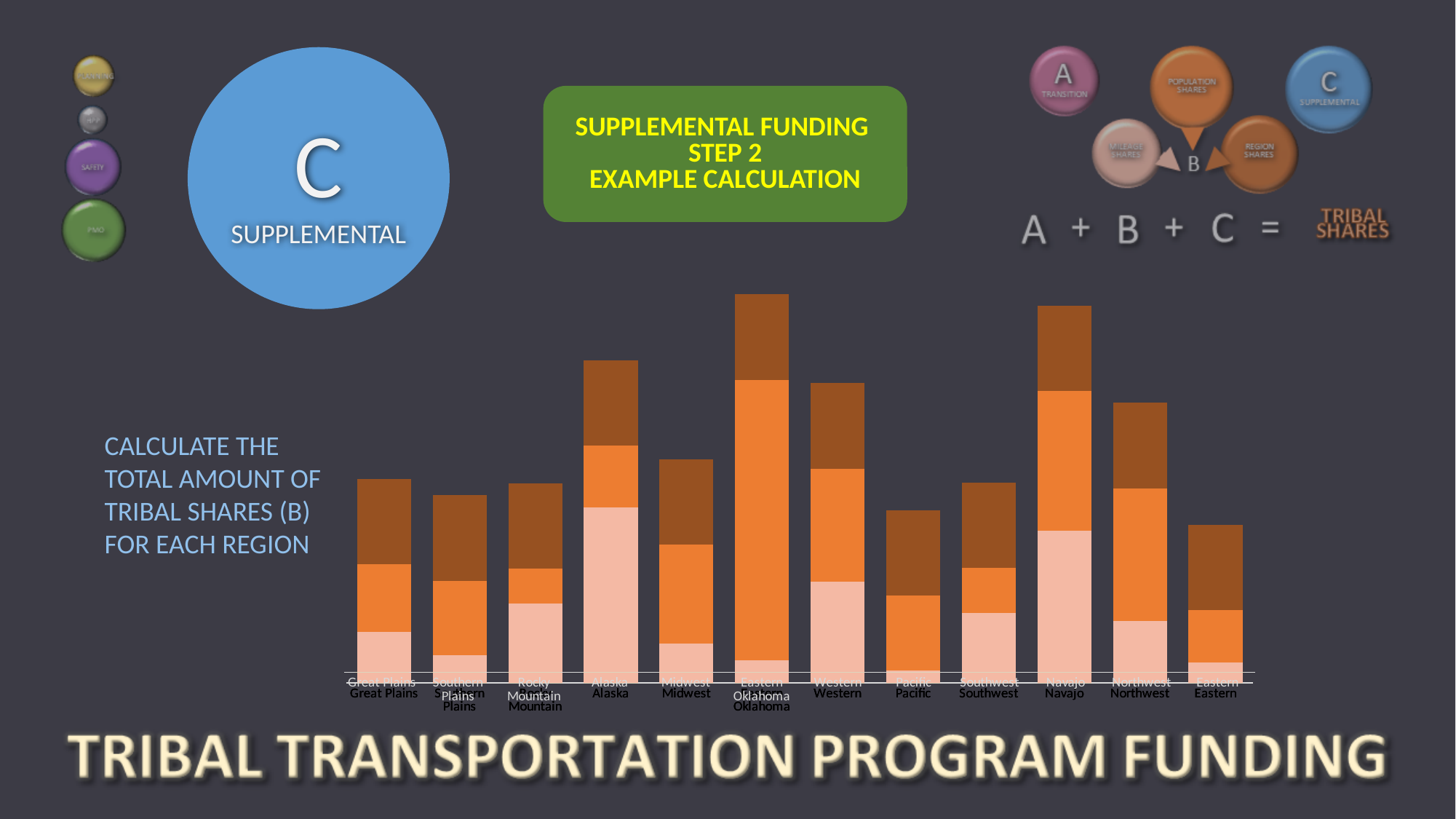
Which region is the rightmost category on the chart's x axis? Eastern Which bar is taller overall, Eastern Oklahoma or Southwest? Eastern Oklahoma How many regions are shown along the x axis of the chart? 12 Which bar is taller overall, Western or Pacific? Western Which bar is taller overall, Alaska or Midwest? Alaska Which region has the largest bottom (lightest-coloured) segment in its bar? Alaska What kind of chart is shown on the slide? Stacked bar chart How many stacked segments make up each bar in the chart? 3 Which region is the leftmost category on the chart's x axis? Great Plains